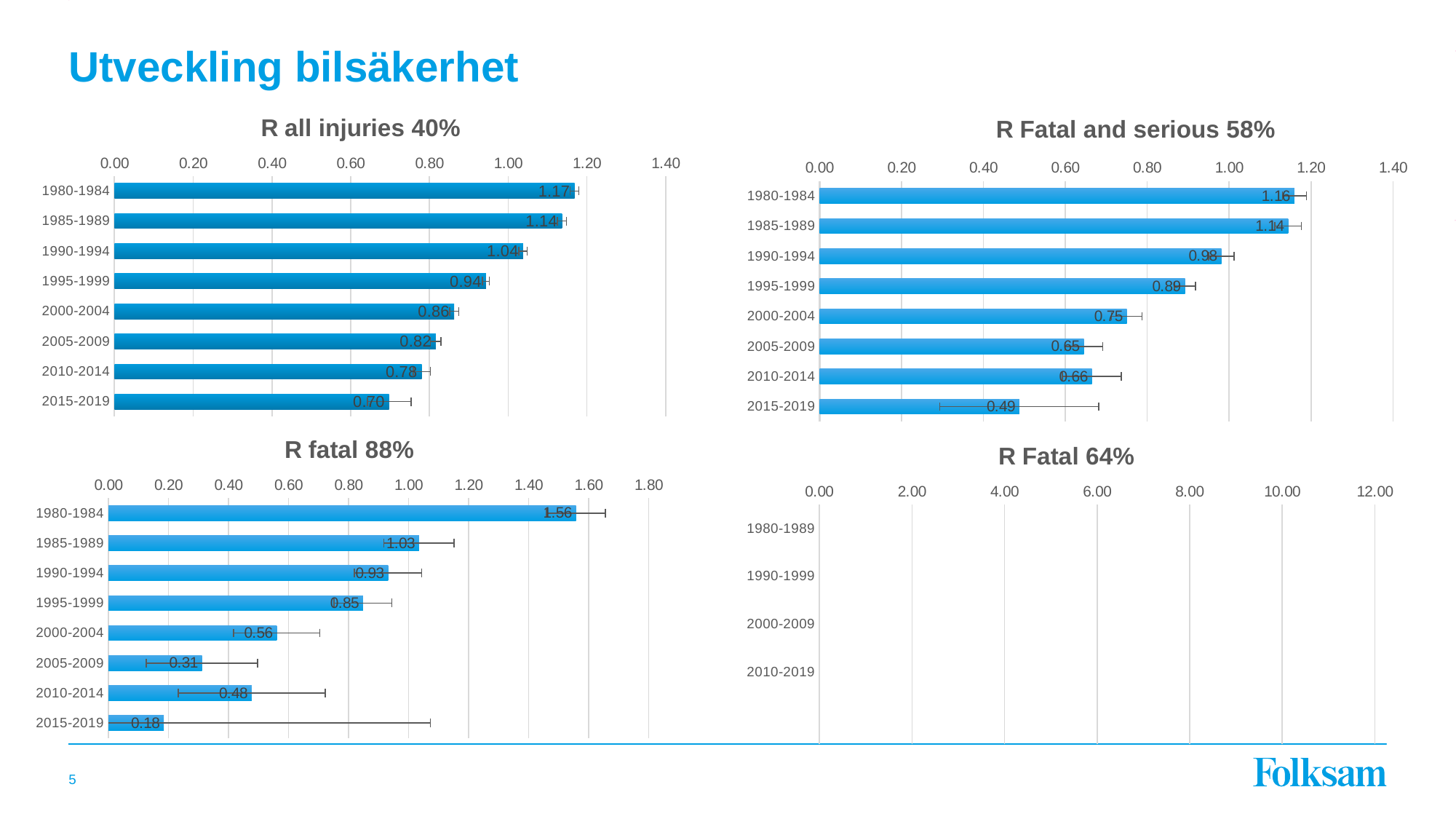
In the 'R Fatal and serious 58%' chart, what is the value for 2000-2004? 0.75 In the 'R all injuries 40%' chart, do the values rise or fall from 1980-1984 to 2015-2019? Fall How many periods are shown in the 'R all injuries 40%' chart? 8 In the 'R all injuries 40%' chart, which period has the highest value? 1980-1984 In the 'R all injuries 40%' chart, what is the difference between the values for 1980-1984 and 2015-2019? 0.47 In the 'R fatal 88%' chart, what is the value for 1980-1984? 1.56 In the 'R all injuries 40%' chart, what is the value for 2015-2019? 0.70 What type of chart is 'R fatal 88%'? Bar chart In the 'R fatal 88%' chart, which is larger, the value for 2005-2009 or the value for 2010-2014? 2010-2014 In the 'R Fatal and serious 58%' chart, is the value for 1990-1994 greater or less than 1.00? less In the 'R Fatal and serious 58%' chart, which period has the lowest value? 2015-2019 In the 'R fatal 88%' chart, what is the difference between the values for 1985-1989 and 1990-1994? 0.10